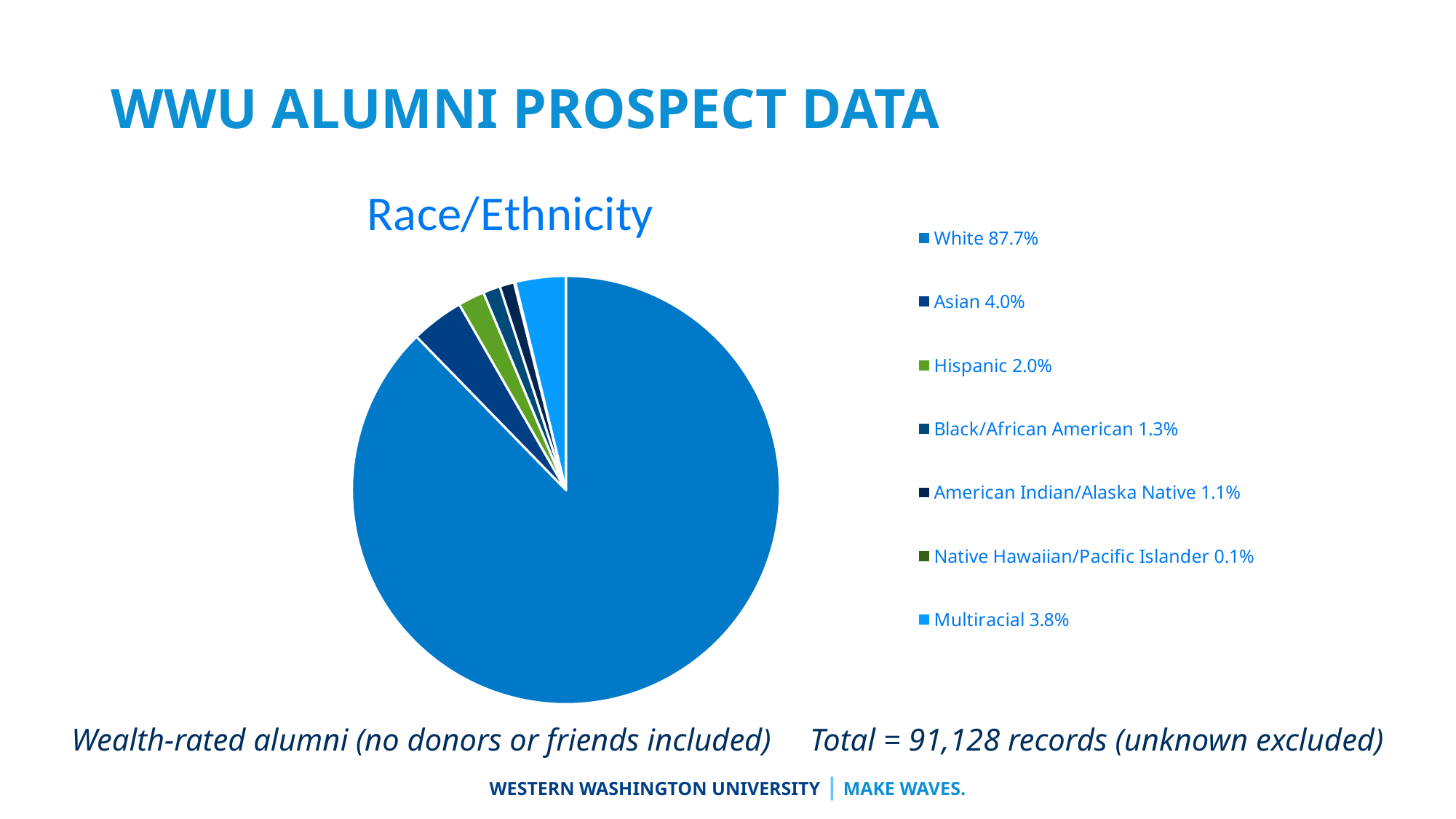
What is the title of the chart? Race/Ethnicity Which is larger, the Asian share or the Multiracial share? Asian What type of chart is shown on the slide? pie chart What share of the pie is White? 87.7% Which category has the largest share of the pie? White What is the difference in percentage points between the Hispanic and American Indian/Alaska Native shares? 0.9 How many categories does the legend list? 7 What share of the pie is Black/African American? 1.3% What share of the pie is Asian? 4.0% What is the total number of records stated on the slide? 91,128 Which category has the smallest share of the pie? Native Hawaiian/Pacific Islander